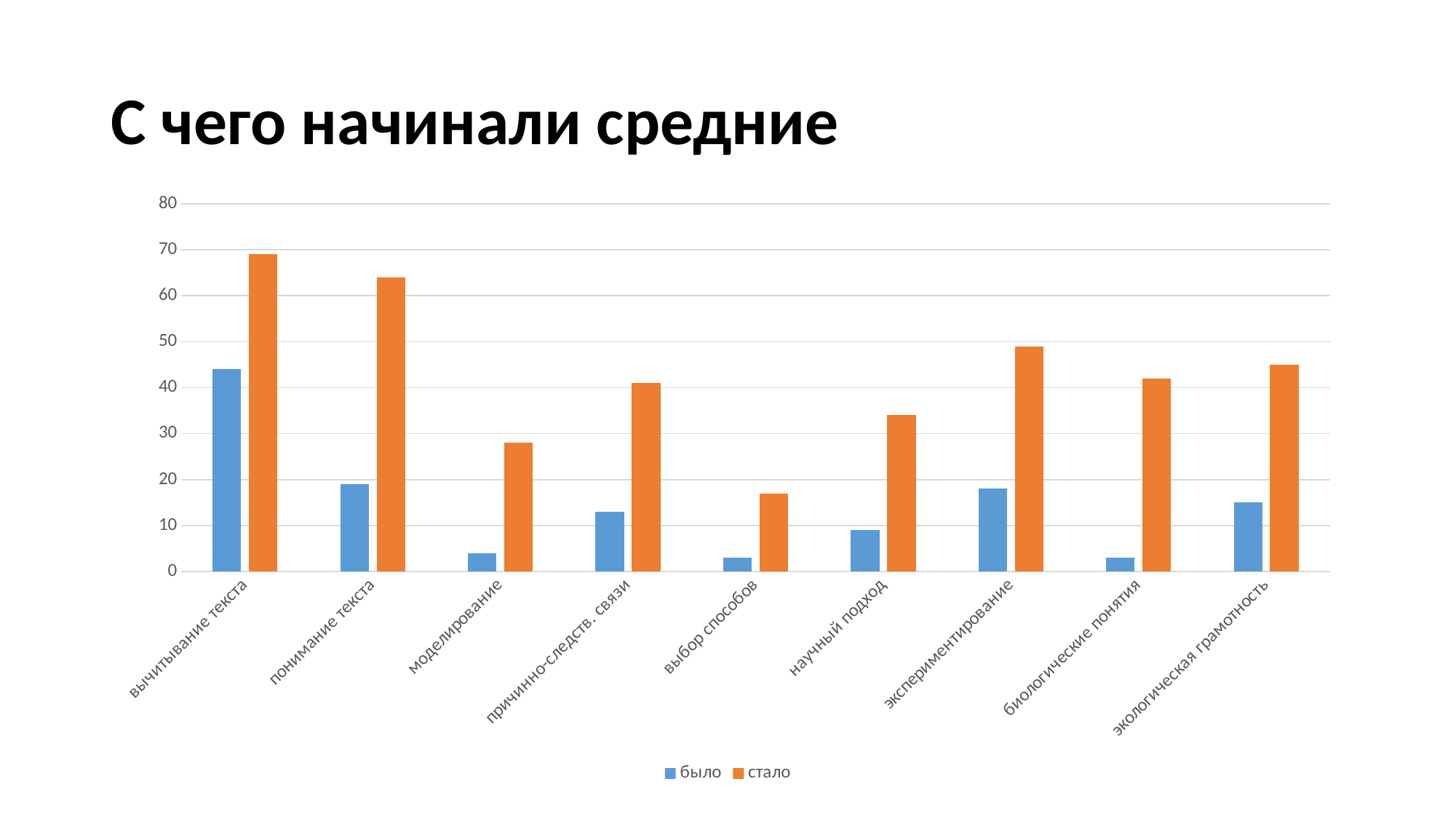
Is the 'стало' value for 'вычитывание текста' greater or less than 60? greater Which category has the highest value for the series 'стало'? вычитывание текста How many categories are shown along the x axis? 9 Is the 'было' value for 'вычитывание текста' greater or less than 40? greater Is the 'стало' value for 'выбор способов' greater or less than 20? less How many series does the legend list? 2 Which category has the highest value for the series 'было'? вычитывание текста Which is larger: the 'стало' value for 'научный подход' or for 'экологическая грамотность'? экологическая грамотность What kind of chart is shown on the slide? bar chart Which category has the lowest value for the series 'стало'? выбор способов What are the two series names listed in the legend? было, стало